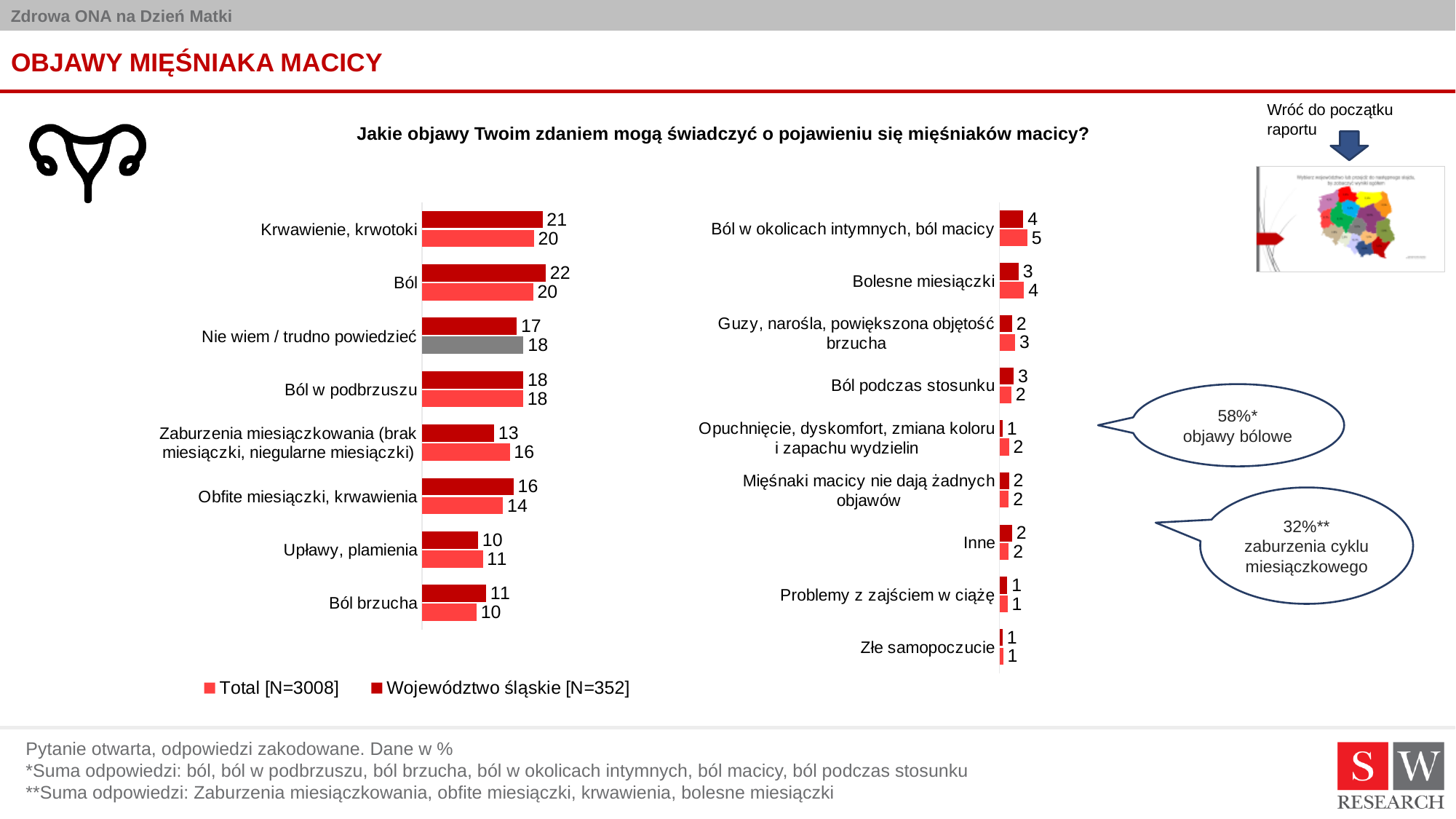
How many series does the legend list? 2 In the left chart, which category has the highest Województwo śląskie [N=352] value? Ból What type of chart is the left chart? Bar chart In the left chart, what is the difference between the Województwo śląskie [N=352] and Total [N=3008] values for Zaburzenia miesiączkowania (brak miesiączki, niegularne miesiączki)? 3 How many categories are shown in the left chart? 8 In the left chart, which is larger for Obfite miesiączki, krwawienia: the Total [N=3008] value or the Województwo śląskie [N=352] value? Województwo śląskie [N=352] In the left chart, what is the Województwo śląskie [N=352] value for Ból? 22 In the right chart, which is larger for Bolesne miesiączki: the Total [N=3008] value or the Województwo śląskie [N=352] value? Total [N=3008] In the right chart, what is the Total [N=3008] value for Ból w okolicach intymnych, ból macicy? 5 In the left chart, what is the Total [N=3008] value for Krwawienie, krwotoki? 20 How many categories are shown in the right chart? 9 In the right chart, which category has the highest Total [N=3008] value? Ból w okolicach intymnych, ból macicy